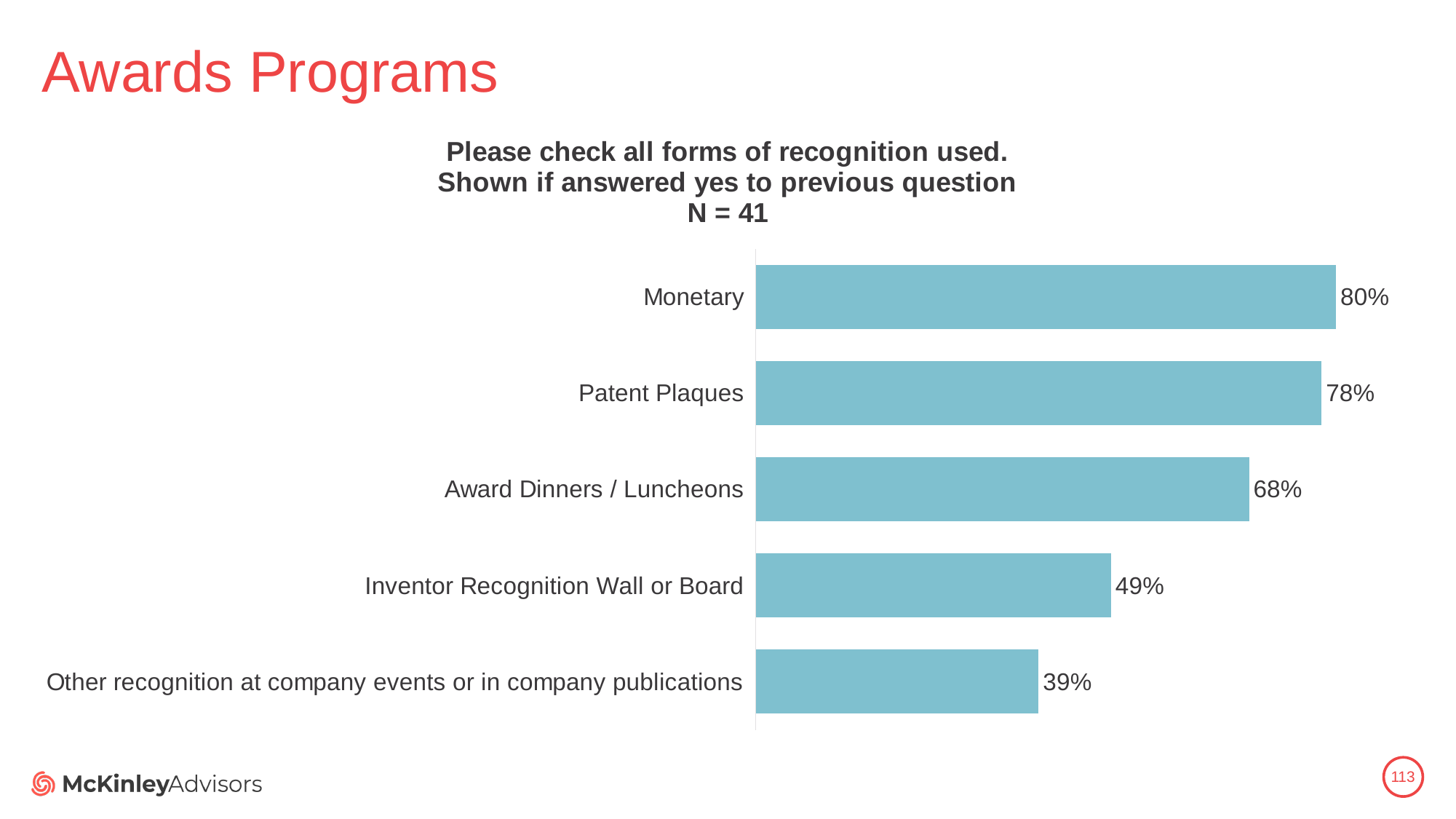
How many forms of recognition are shown in the chart? 5 What is the value for Inventor Recognition Wall or Board? 49% What is the difference in percentage points between Monetary and Inventor Recognition Wall or Board? 31 Which form of recognition has the highest percentage? Monetary What is the sample size (N) stated in the chart title? 41 What kind of chart is shown on the slide? Bar chart Which is larger, the value for Award Dinners / Luncheons or the value for Inventor Recognition Wall or Board? Award Dinners / Luncheons What percentage of respondents use Monetary recognition? 80% Which form of recognition has the lowest percentage? Other recognition at company events or in company publications What percentage is shown for Other recognition at company events or in company publications? 39% What is the value for Patent Plaques? 78% What percentage is shown for Award Dinners / Luncheons? 68%